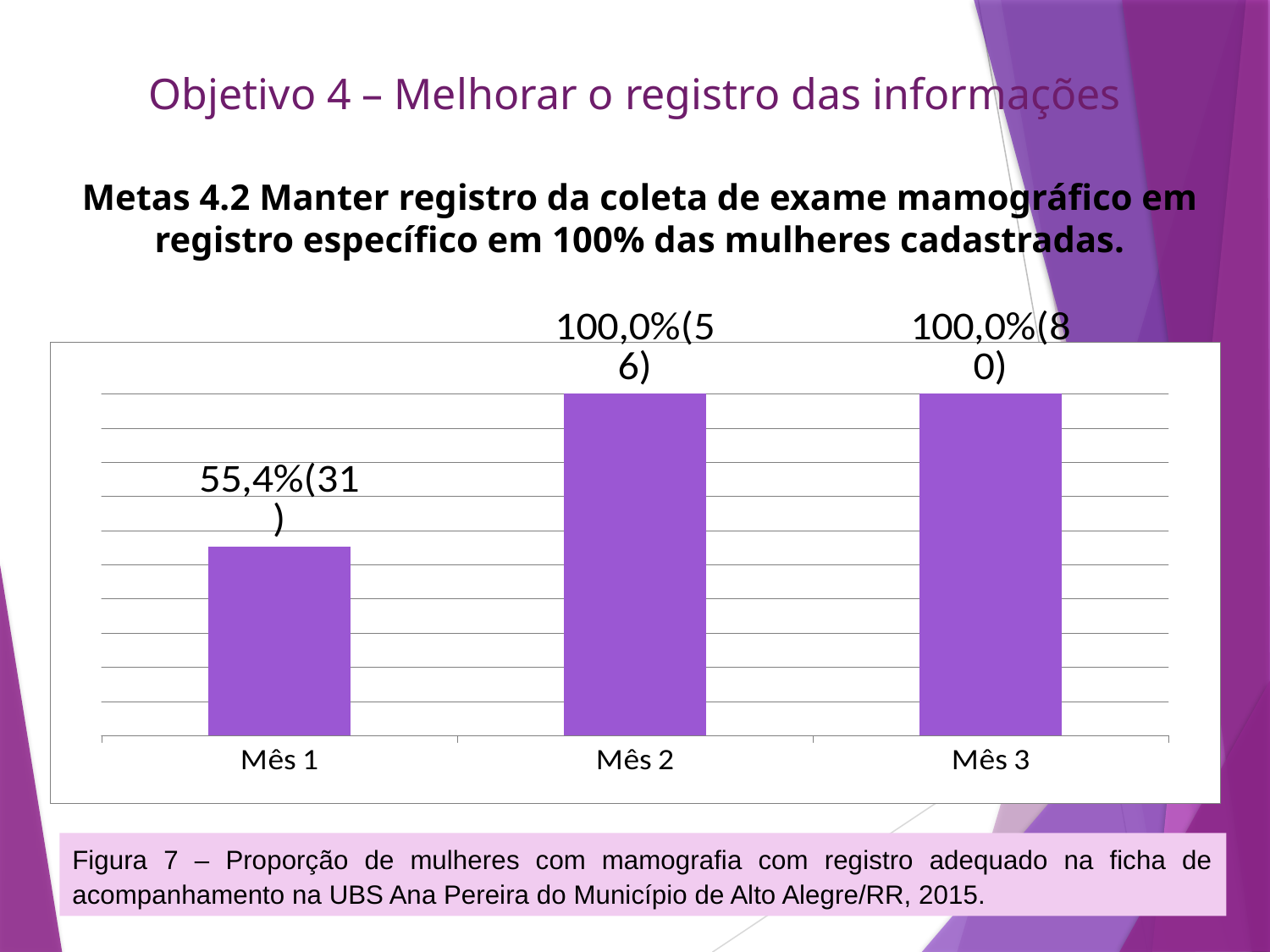
How many women are counted in parentheses for Mês 3? 80 Which month has the lowest proportion? Mês 1 Do the values rise or fall from Mês 1 to Mês 2? Rise What is the value shown for Mês 2? 100,0%(56) How many categories (months) are shown on the x axis? 3 Which is larger, the value for Mês 1 or the value for Mês 3? Mês 3 What is the difference in percentage points between Mês 2 and Mês 1? 44,6 What is the value shown for Mês 3? 100,0%(80) What is the figure number given in the caption below the chart? Figura 7 What kind of chart is shown on the slide? Bar chart What is the value shown for Mês 1? 55,4%(31) What colour are the bars in the chart? Purple